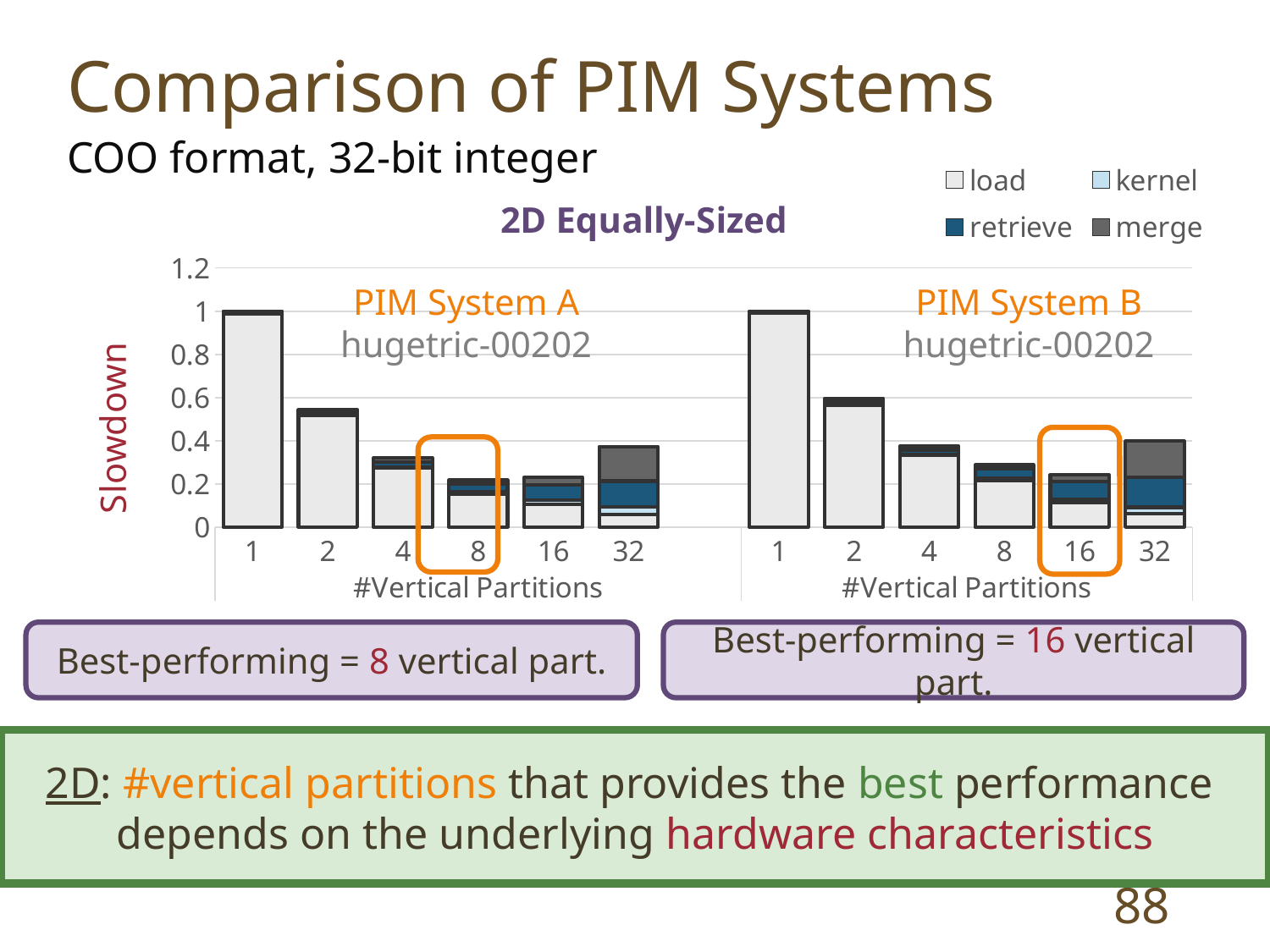
In the PIM System A chart, which number of vertical partitions has the lowest slowdown? 8 In the PIM System A chart, is the slowdown for 2 vertical partitions greater or less than 0.4? greater How many #Vertical Partitions categories are shown in the PIM System B chart? 6 In the PIM System B chart, is the slowdown for 4 vertical partitions greater or less than 0.6? less In the PIM System B chart, does the slowdown rise or fall as the number of vertical partitions goes from 1 to 8? fall In the PIM System B chart, which number of vertical partitions has the lowest slowdown? 16 In the PIM System A chart, which has the larger slowdown: 2 vertical partitions or 4 vertical partitions? 2 vertical partitions In the PIM System B chart, which number of vertical partitions has the highest slowdown? 1 In the PIM System A chart, what is the slowdown for 1 vertical partition? 1 What kind of chart is used for PIM System A? Stacked bar chart Which series are listed in the legend? load, kernel, retrieve, merge How many series does the legend list? 4